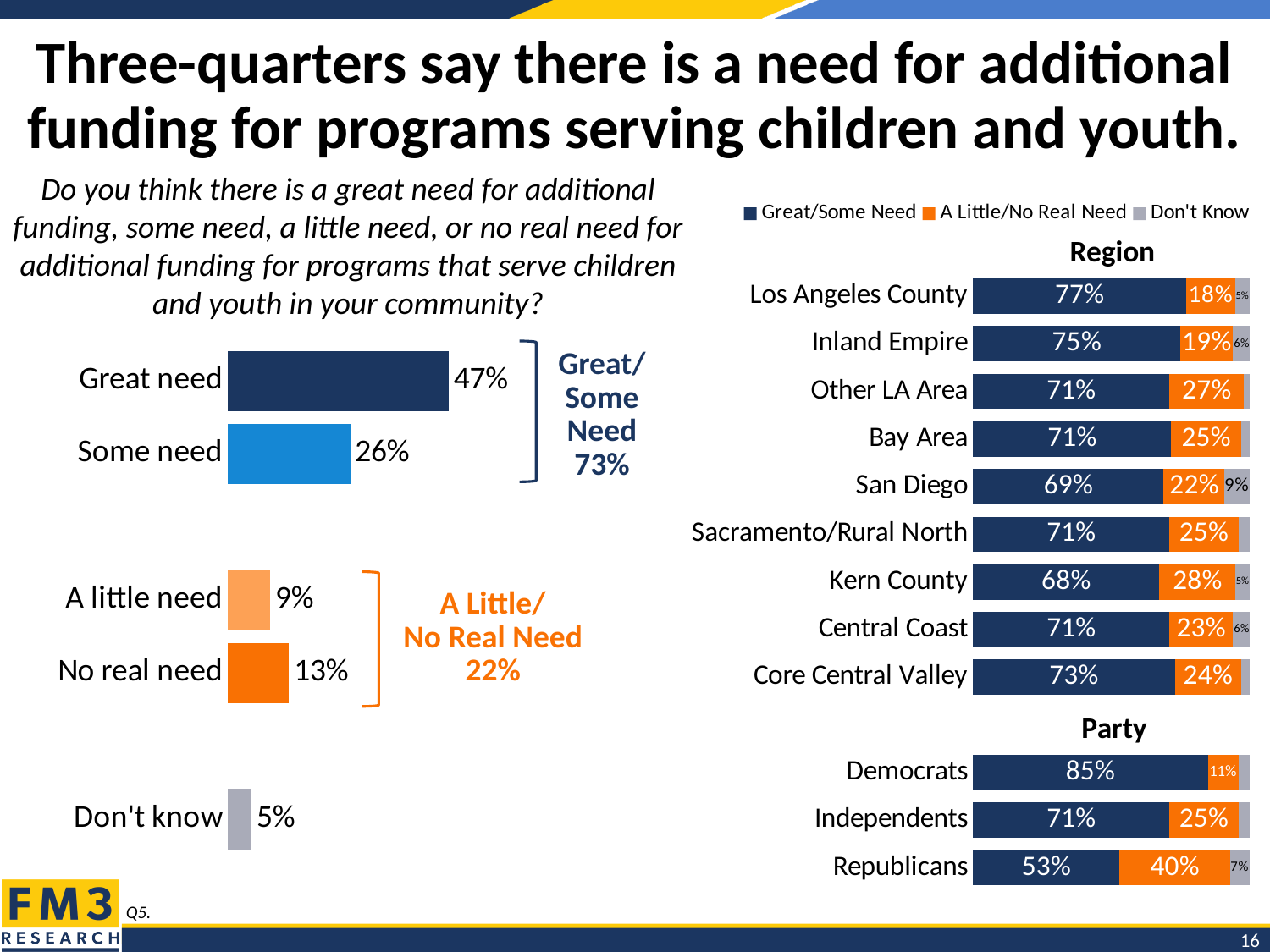
On the left bar chart, what percentage of respondents said there is a great need for additional funding? 47% On the right-hand chart, which region has the highest Great/Some Need value? Los Angeles County How many response categories are shown on the left bar chart? 5 On the right-hand chart, what is the difference between the Great/Some Need values for Democrats and Republicans? 32 percentage points On the left bar chart, which response category has the highest value? Great need How many series does the legend of the right-hand chart list? 3 On the left bar chart, which response category has the lowest value? Don't know What kind of chart is the chart on the left side of the slide? Bar chart On the right-hand chart, what is the Great/Some Need value for Los Angeles County? 77% On the right-hand chart, which has a larger Great/Some Need value, Democrats or Republicans? Democrats On the left bar chart, what is the difference between the 'Great need' and 'Some need' values? 21 percentage points On the right-hand chart, what is the A Little/No Real Need value for Republicans? 40%